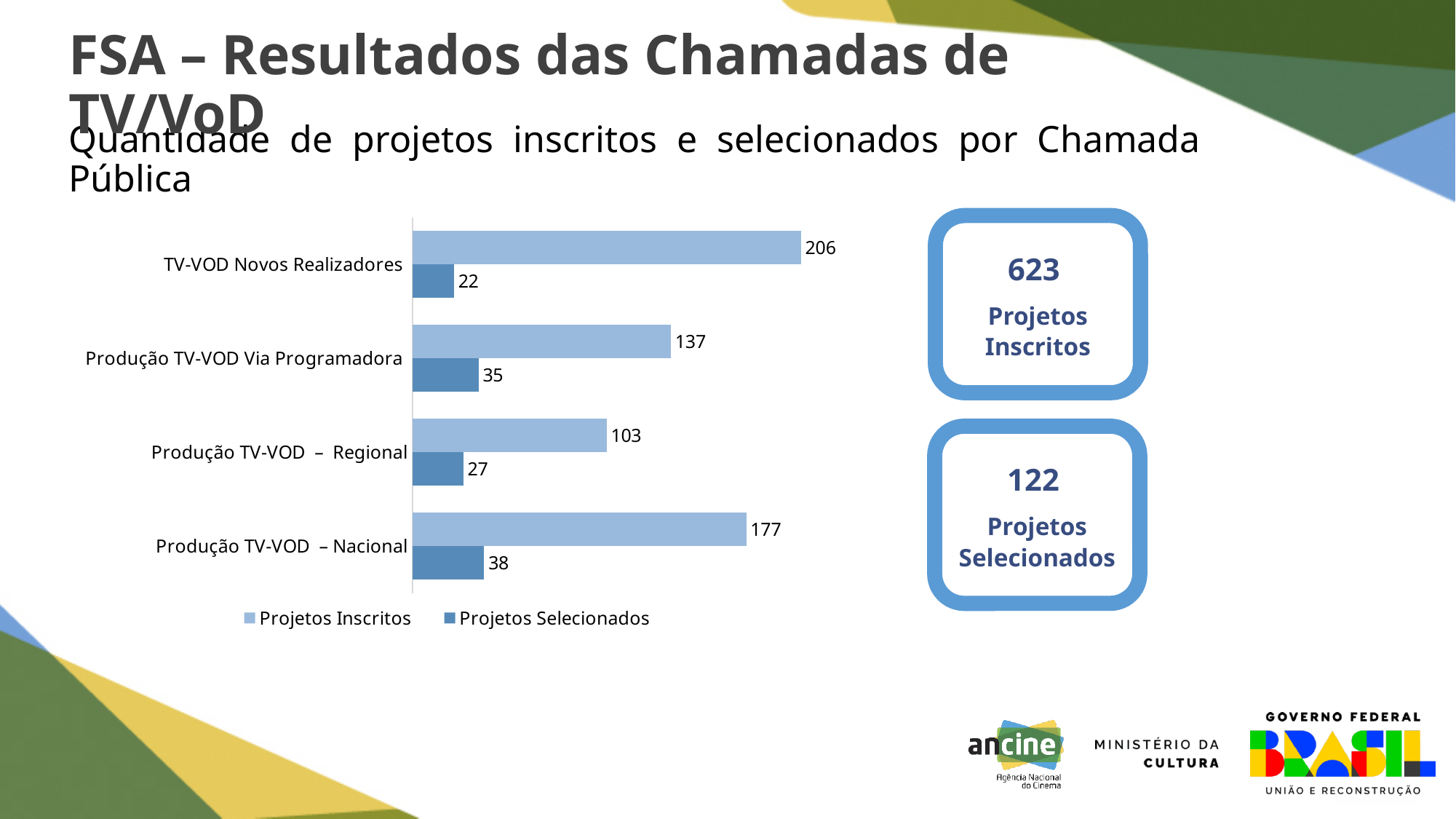
How many Projetos Selecionados are shown for Produção TV-VOD Via Programadora? 35 How many Projetos Inscritos are shown for Produção TV-VOD – Regional? 103 How many Projetos Selecionados are shown for Produção TV-VOD – Nacional? 38 What are the two series named in the chart legend? Projetos Inscritos and Projetos Selecionados Which category has the lowest number of Projetos Selecionados? TV-VOD Novos Realizadores Which category has the highest number of Projetos Inscritos? TV-VOD Novos Realizadores What kind of chart is shown on the slide? Bar chart What is the difference between Projetos Inscritos and Projetos Selecionados for Produção TV-VOD – Nacional? 139 How many series does the legend list? 2 How many categories are shown on the chart? 4 How many Projetos Inscritos are shown for TV-VOD Novos Realizadores? 206 Which has more Projetos Inscritos: Produção TV-VOD Via Programadora or Produção TV-VOD – Regional? Produção TV-VOD Via Programadora